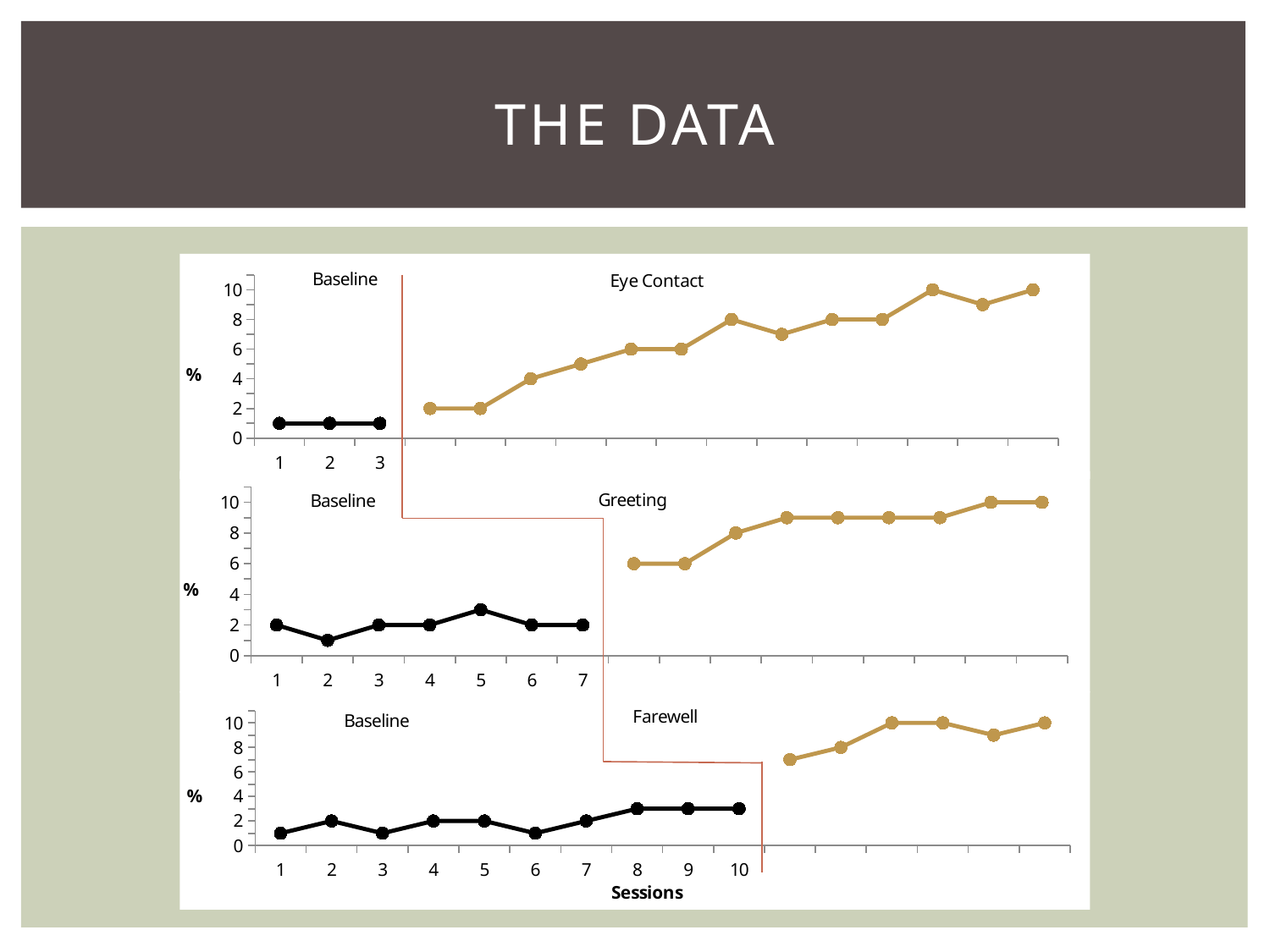
What kind of chart is used for the Eye Contact, Greeting and Farewell data on this slide? line chart In the Farewell chart, what is the value for session 2? 2 In the Eye Contact chart, how many baseline sessions are plotted? 3 How many charts are shown on the slide? 3 In the Greeting chart, what is the value for session 1? 2 In the Greeting chart, which baseline session has the lowest value? 2 In the Greeting chart, which baseline session has the highest value? 5 In the Farewell chart, is the value of the first intervention point greater or less than 6? greater What is the label on the x axis at the bottom of the slide? Sessions In the Farewell chart, how many baseline sessions are plotted? 10 In the Farewell chart, which is larger, the value for session 8 or the value for session 1? session 8 In the Eye Contact chart, do the values in the intervention phase generally rise or fall across sessions? rise